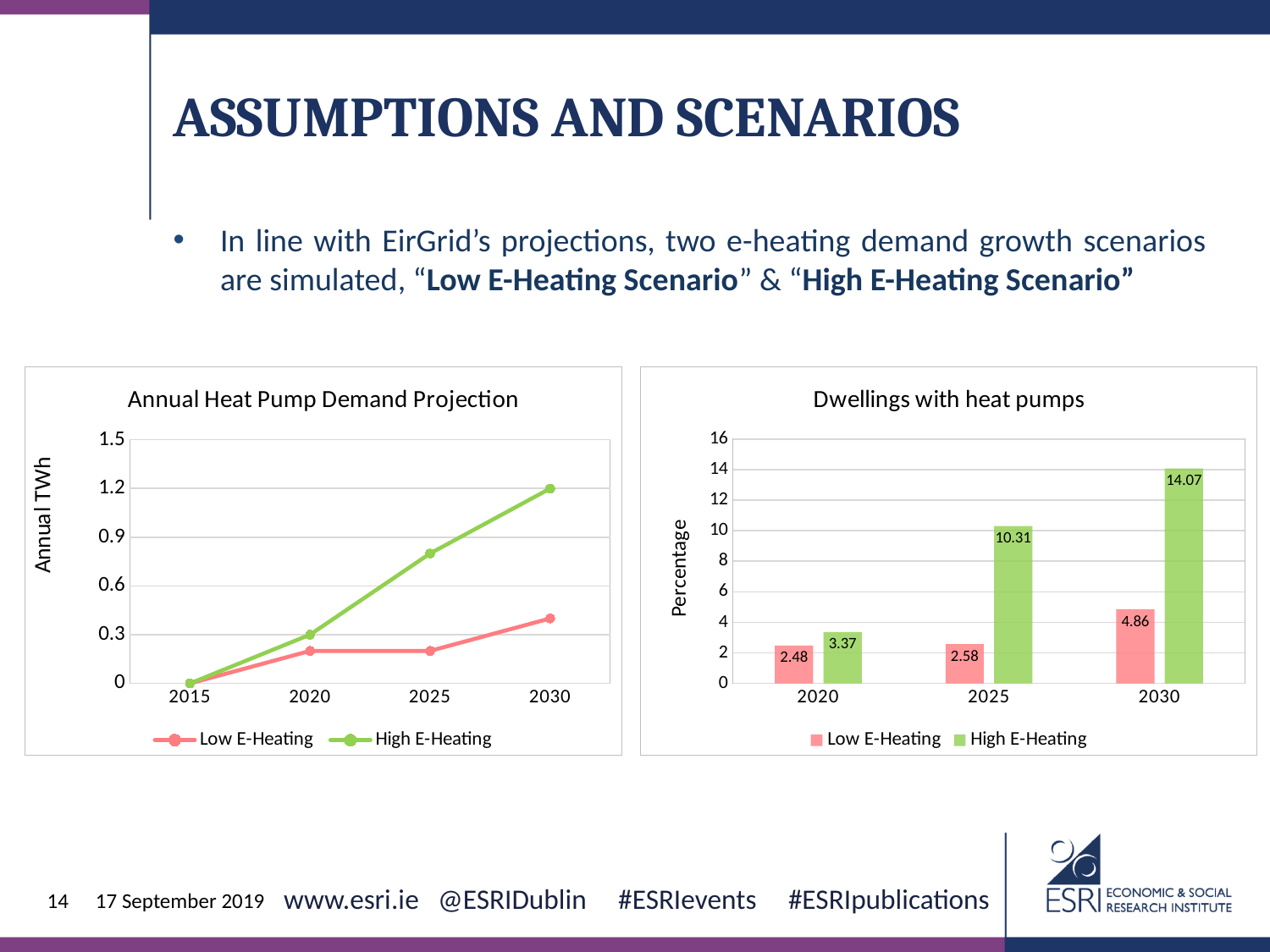
In the 'Annual Heat Pump Demand Projection' chart, is the Low E-Heating value for 2030 greater or less than 0.6? less What kind of chart is 'Annual Heat Pump Demand Projection'? Line chart How many years are shown on the x axis of the 'Annual Heat Pump Demand Projection' chart? 4 In the 'Dwellings with heat pumps' chart, which year has the lowest Low E-Heating value? 2020 In the 'Dwellings with heat pumps' chart, what is the value for Low E-Heating in 2020? 2.48 In the 'Dwellings with heat pumps' chart, which is larger: Low E-Heating in 2030 or High E-Heating in 2020? Low E-Heating in 2030 How many series does the legend of the 'Dwellings with heat pumps' chart list? 2 In the 'Dwellings with heat pumps' chart, what is the difference between the High E-Heating and Low E-Heating values in 2030? 9.21 In the 'Annual Heat Pump Demand Projection' chart, is the High E-Heating value for 2025 greater or less than 0.6? greater In the 'Dwellings with heat pumps' chart, what is the value for High E-Heating in 2030? 14.07 In the 'Dwellings with heat pumps' chart, what is the value for High E-Heating in 2025? 10.31 What is the y-axis label of the 'Annual Heat Pump Demand Projection' chart? Annual TWh